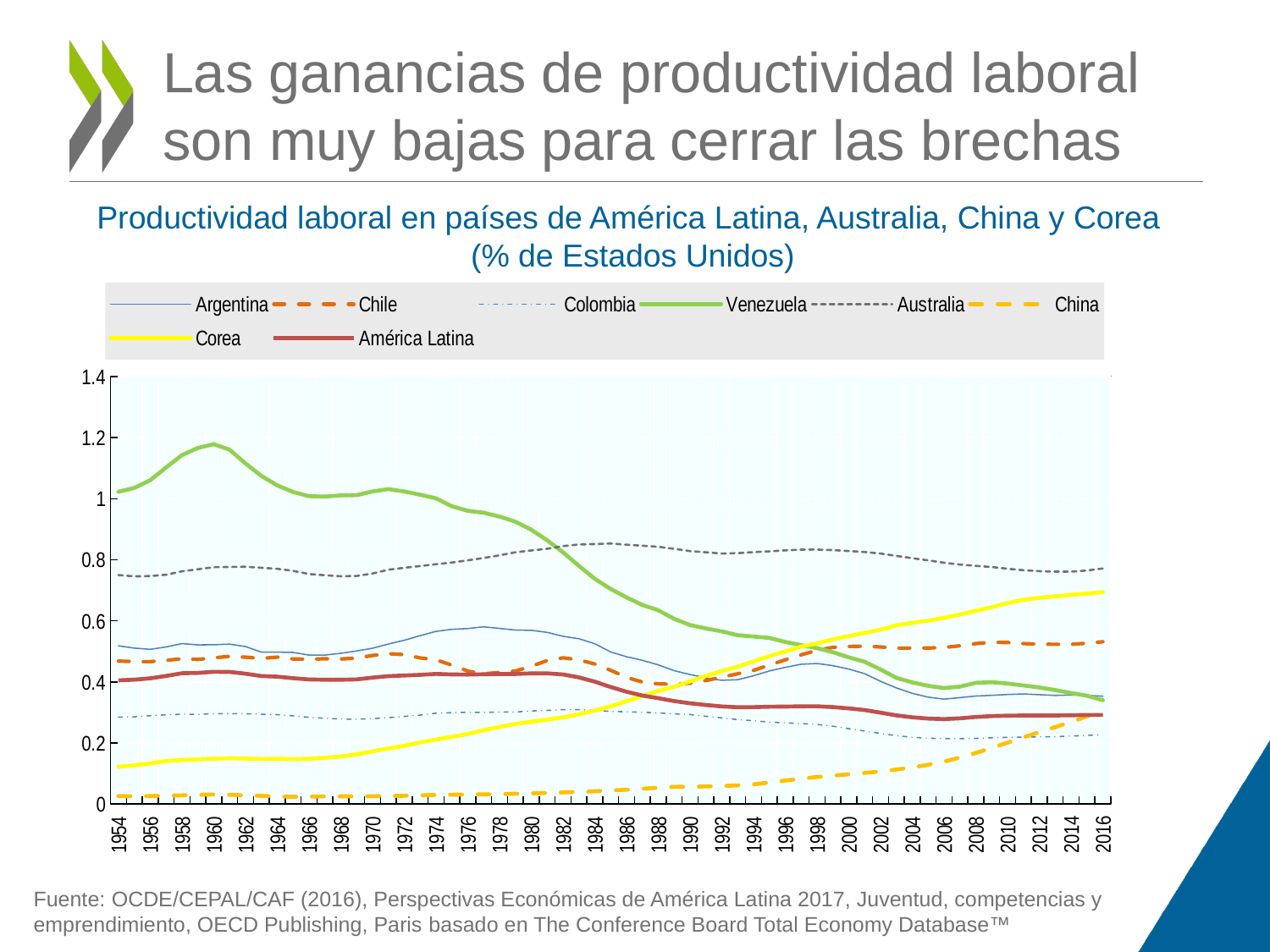
Is the value for China in 1990 greater or less than 0.2? less Which series has the highest value in 1960? Venezuela Does the value for Venezuela rise or fall from 1960 to 2016? fall Is the value for Corea in 2016 greater or less than 0.6? greater What is the title of the chart? Productividad laboral en países de América Latina, Australia, China y Corea (% de Estados Unidos) Does the value for Corea rise or fall from 1954 to 2016? rise How many series does the legend list? 8 What kind of chart is shown on the slide? line chart In 2016, which is higher, Corea or Chile? Corea Is the value for Venezuela in 1960 greater or less than 1? greater Which series has the highest value in 2016? Australia Which series has the lowest value in 1954? China